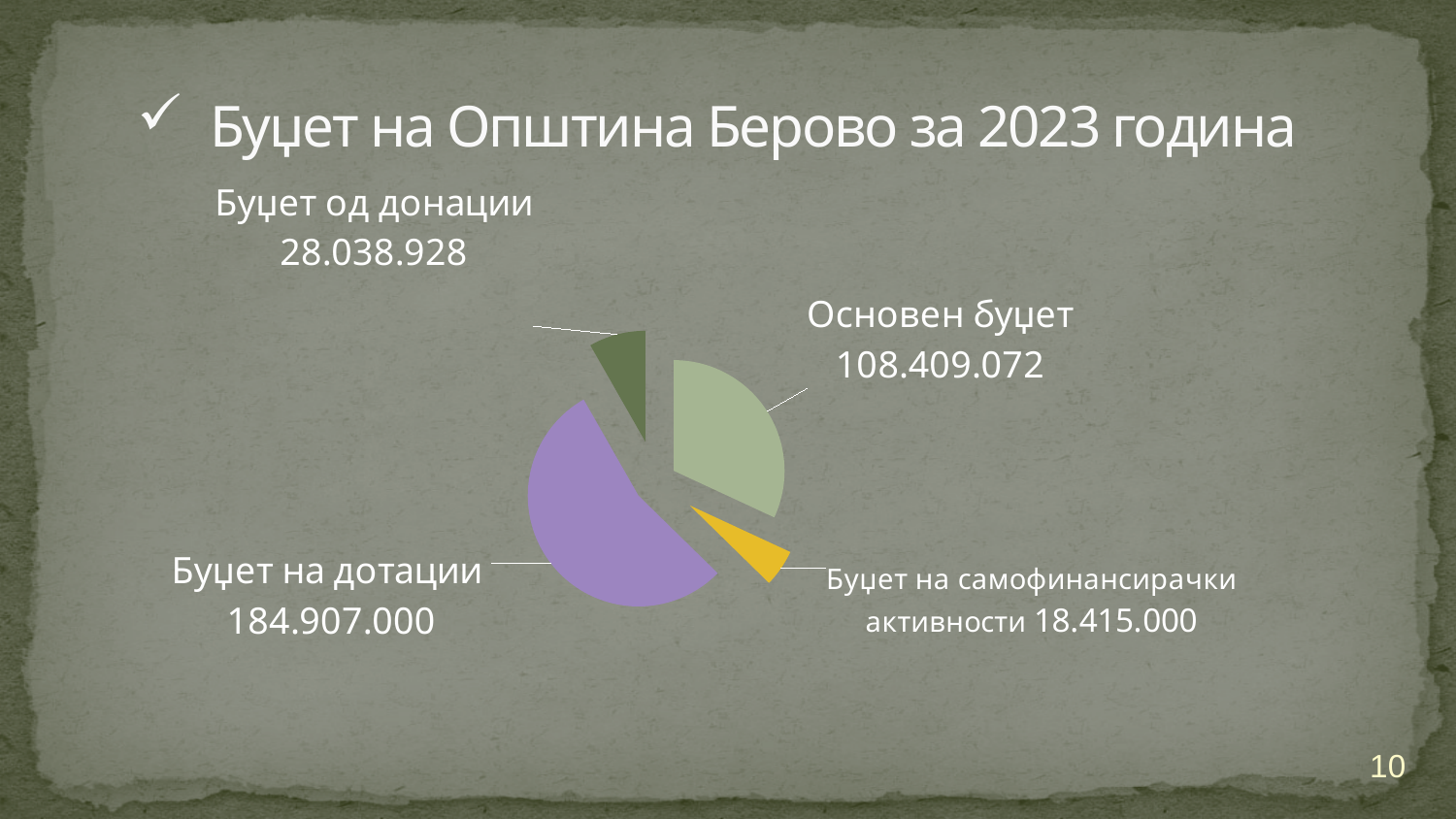
Which is larger, Основен буџет or Буџет од донации? Основен буџет What kind of chart is shown on the slide? Pie chart What is the difference between Буџет на дотации and Основен буџет? 76.497.928 What is the value for Буџет на самофинансирачки активности in the pie chart? 18.415.000 What is the value for Буџет од донации in the pie chart? 28.038.928 Which category has the largest slice in the pie chart? Буџет на дотации How many slices does the pie chart have? 4 What is the value for Буџет на дотации in the pie chart? 184.907.000 What colour is the slice for Буџет на дотации? Purple Which category has the smallest slice in the pie chart? Буџет на самофинансирачки активности What is the difference between Буџет од донации and Буџет на самофинансирачки активности? 9.623.928 What is the value for Основен буџет in the pie chart? 108.409.072